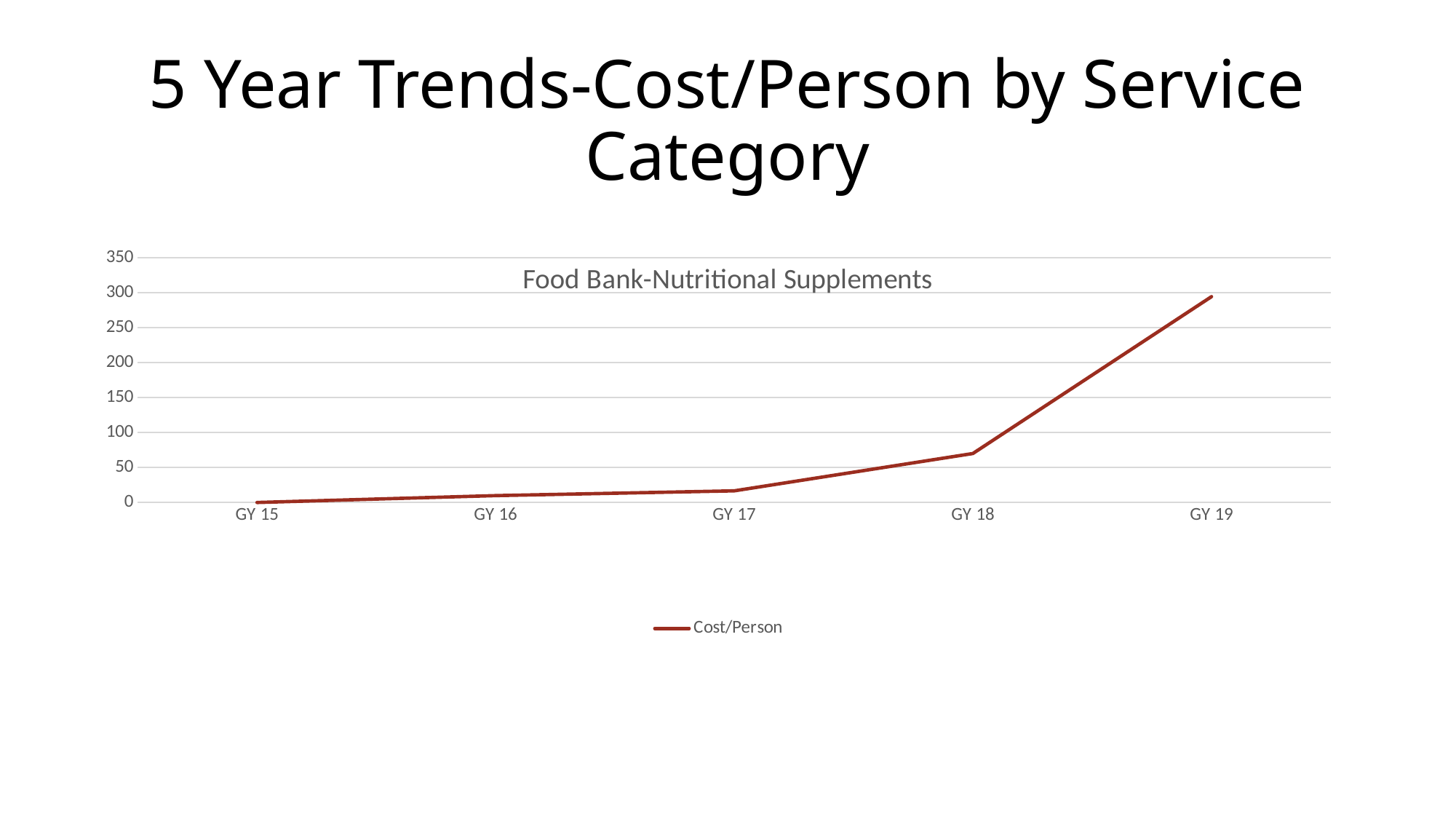
Which has a larger Cost/Person, GY 17 or GY 18? GY 18 Which grant year has the highest Cost/Person? GY 19 Which has a larger Cost/Person, GY 18 or GY 19? GY 19 Is the Cost/Person value for GY 17 greater or less than 50? less Is the Cost/Person value for GY 18 greater or less than 100? less What is the name of the series shown in the legend? Cost/Person Is the Cost/Person value for GY 19 greater or less than 250? greater What kind of chart is shown on the slide? line chart How many grant years (points) are plotted along the x axis? 5 What is the title of the chart? Food Bank-Nutritional Supplements How many series does the legend list? 1 Do the Cost/Person values rise or fall from GY 15 to GY 19? rise